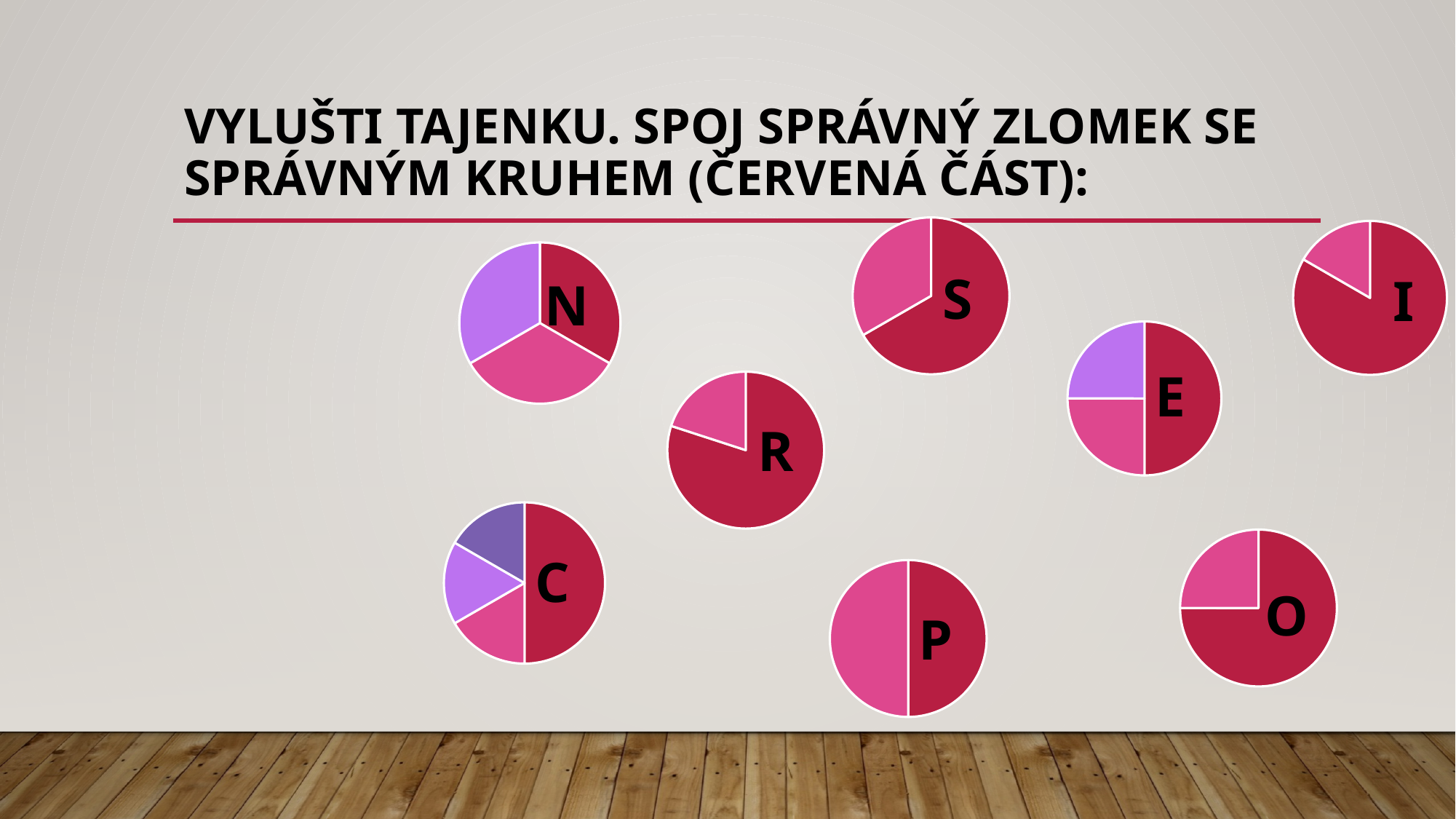
How many slices does the pie chart labelled N have? 3 How many slices does the pie chart labelled P have? 2 Which is larger: the red slice in the pie chart labelled O or the red slice in the pie chart labelled P? O Which is larger: the pink slice in the pie chart labelled P or the pink slice in the pie chart labelled R? P What kind of chart is the chart labelled N? pie chart What letter labels the pie chart in the bottom-right corner of the slide? O How many slices does the pie chart labelled C have? 4 What colour is the largest slice in the pie chart labelled I? red Which is larger: the red slice in the pie chart labelled I or the red slice in the pie chart labelled N? I Which pie chart on the slide has the most slices? C